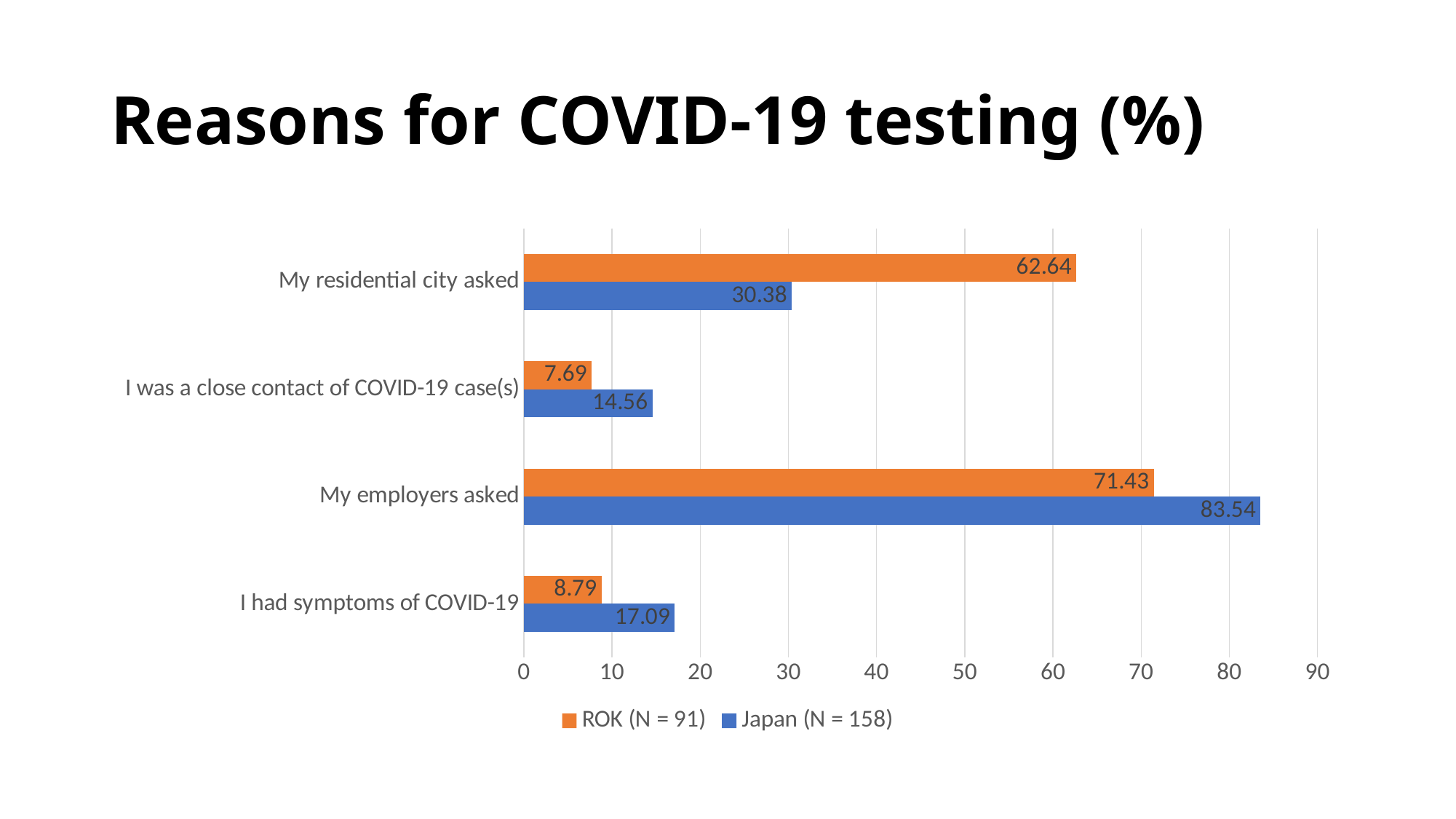
Is the value for Japan (N = 158) for 'My residential city asked' greater or less than 40? less Which reason has the highest value for ROK (N = 91)? My employers asked What is the difference between the Japan (N = 158) and ROK (N = 91) values for 'My employers asked'? 12.11 What is the value for Japan (N = 158) for 'My employers asked'? 83.54 Which reason has the lowest value for Japan (N = 158)? I was a close contact of COVID-19 case(s) How many reasons (categories) are shown on the chart? 4 What kind of chart is shown on the slide? Bar chart How many series does the legend list? 2 What is the value for Japan (N = 158) for 'I had symptoms of COVID-19'? 17.09 What is the value for ROK (N = 91) for 'My residential city asked'? 62.64 For 'My residential city asked', which series has the larger value, ROK (N = 91) or Japan (N = 158)? ROK (N = 91) What colour represents Japan (N = 158) in the chart? Blue